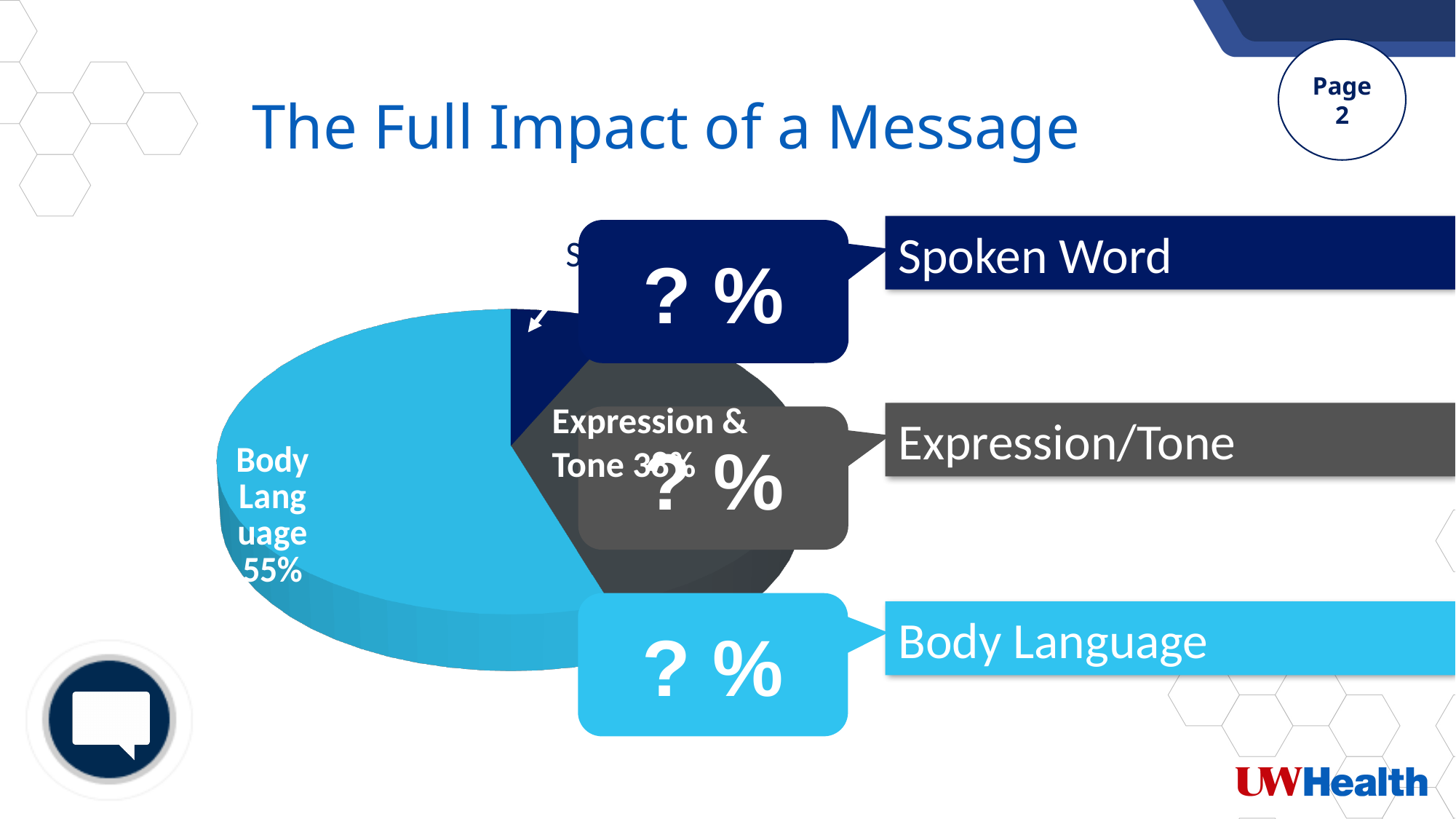
What colour is the Body Language slice of the pie chart? light blue What is the title of the slide containing the pie chart? The Full Impact of a Message How many slices does the pie chart have? 3 What kind of chart is shown on the slide? pie chart Which is larger in the pie chart, the Body Language slice or the Expression & Tone slice? Body Language Which slice of the pie chart is the largest? Body Language Is the Body Language share of the pie chart greater or less than 50%? greater Which slice of the pie chart is the smallest? Spoken Word What percentage is shown for the Body Language slice of the pie chart? 55% What share of the pie does the Body Language slice represent? 55% Is the Expression & Tone share of the pie chart greater or less than 50%? less